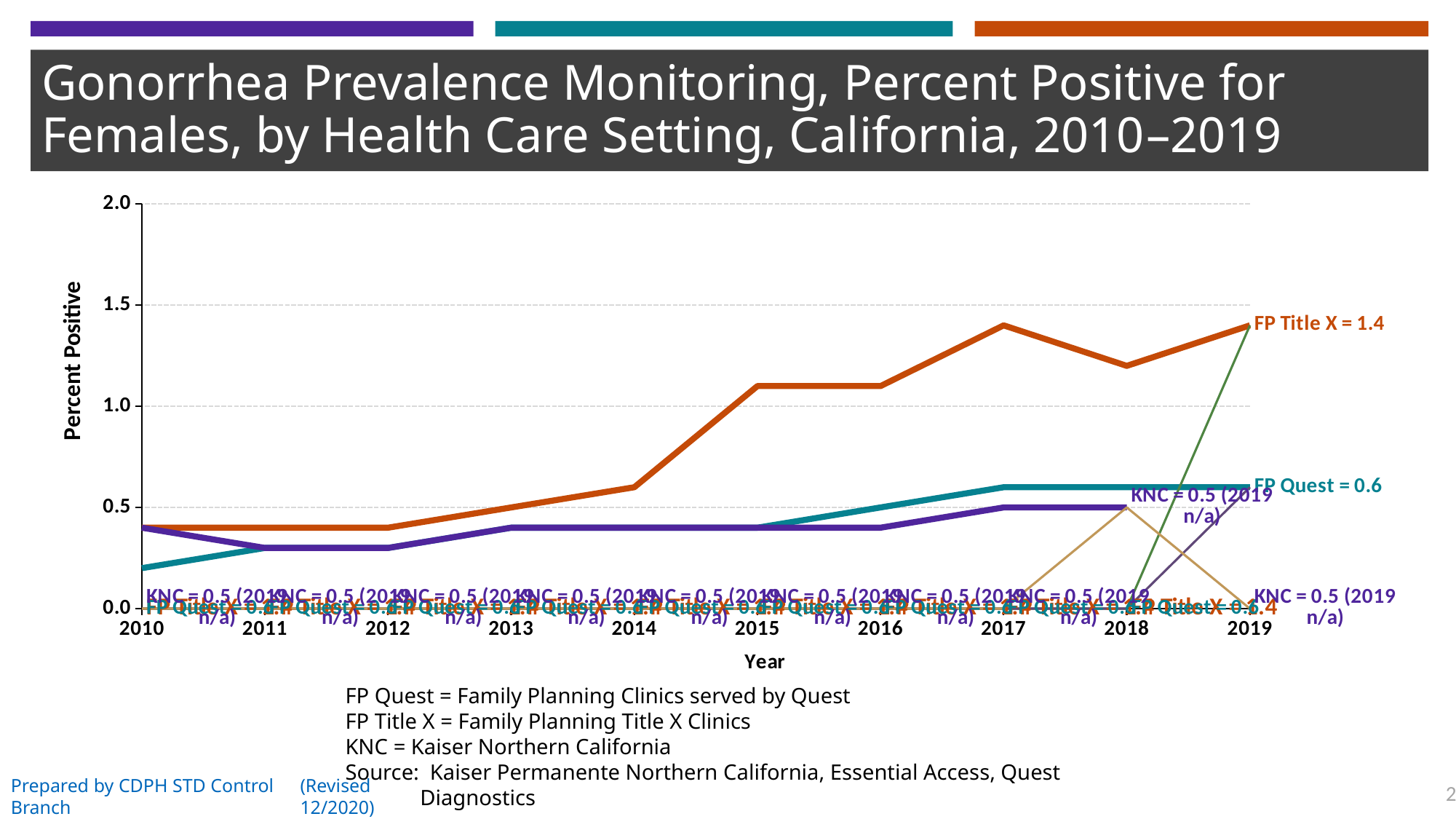
What is the percent positive for FP Title X in 2019? 1.4 What is the title of the y axis? Percent Positive How many years are shown on the x axis? 10 What is the percent positive for FP Quest in 2019? 0.6 In 2019, which is larger: the value for FP Quest or the value for KNC (0.5)? FP Quest What is the difference between the 2019 values for FP Title X and FP Quest? 0.8 Which health care setting has the highest percent positive in 2019? FP Title X Is the value for FP Title X in 2014 greater or less than 1.0? less What value does the chart label give for KNC (with 2019 marked n/a)? 0.5 Is the value for FP Title X in 2017 greater or less than 1.0? greater What type of chart is shown on the slide? line chart Does the FP Title X line generally rise or fall from 2010 to 2019? rise